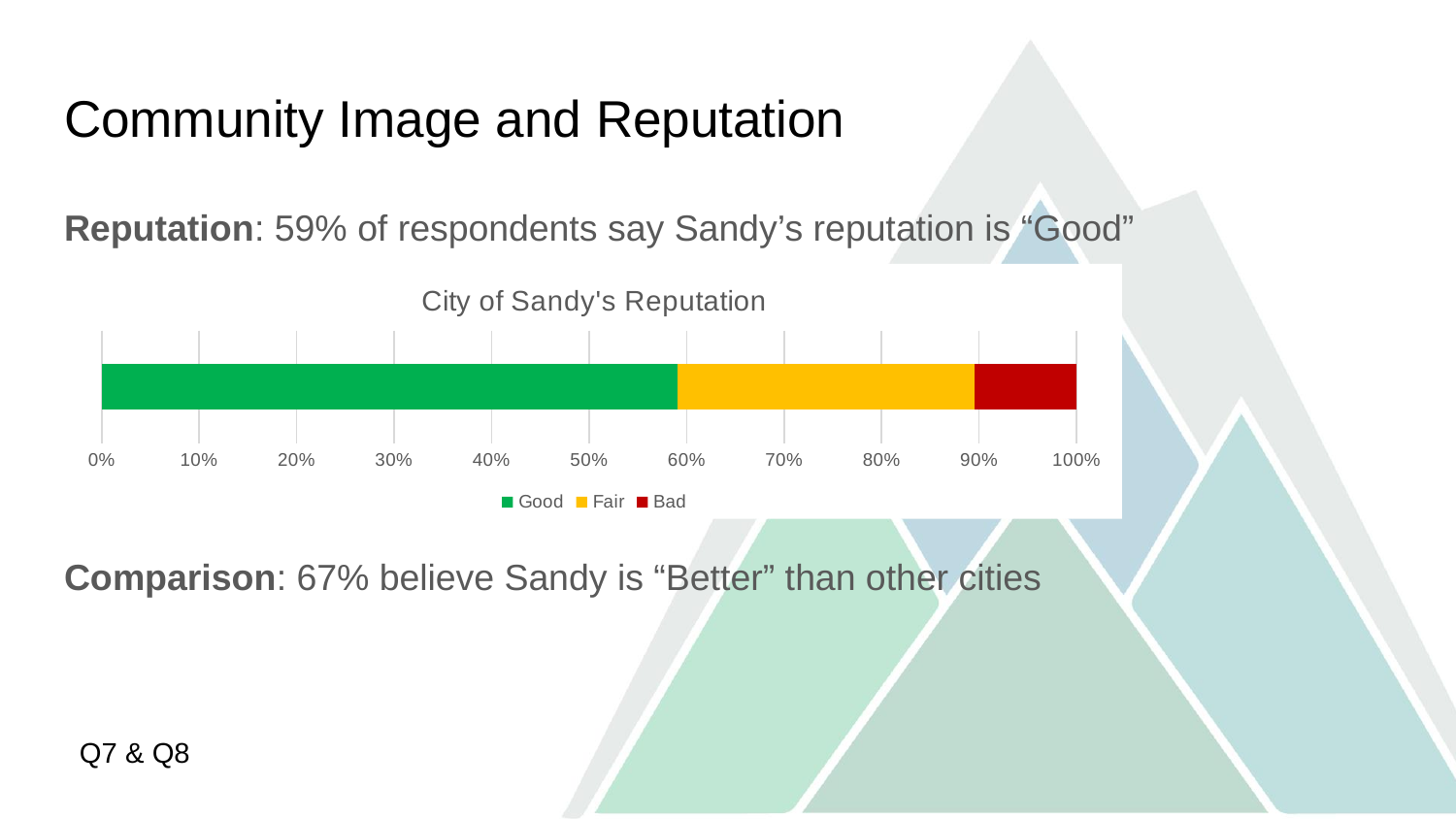
What colour represents the "Bad" series in the chart? red Which rating category makes up the smallest portion of the bar? Bad What is the title of the chart? City of Sandy's Reputation What is the highest value shown on the chart's x axis? 100% Is the value for "Good" greater or less than 50%? greater Which is larger, the "Fair" segment or the "Bad" segment? Fair Is the value for "Fair" greater or less than 20%? greater How many series does the chart's legend list? 3 What share of respondents rated Sandy's reputation as "Good"? 59% Which rating category makes up the largest portion of the bar? Good Is the value for "Bad" greater or less than 20%? less What kind of chart is shown on the slide? bar chart